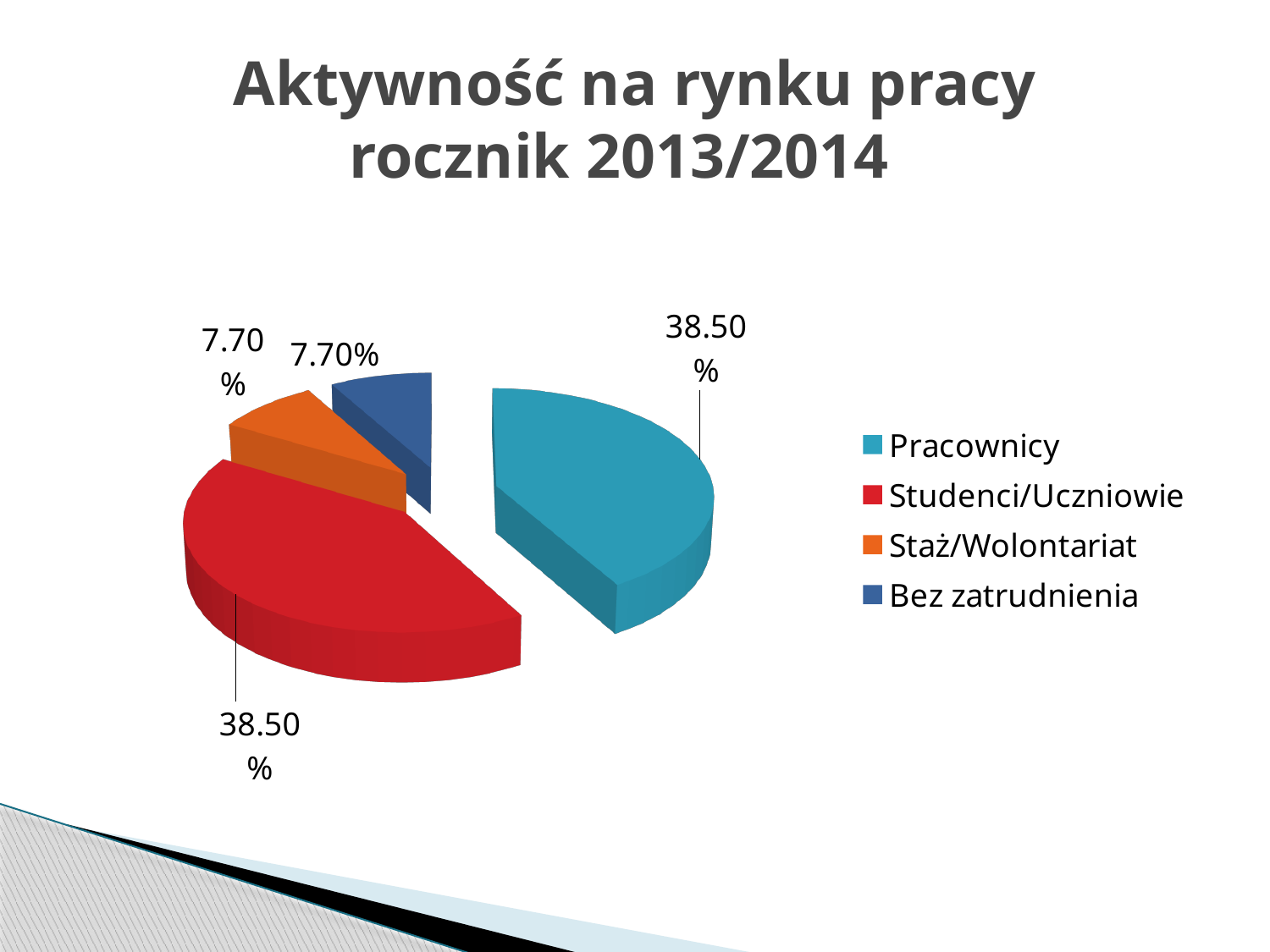
What is the combined share of Pracownicy and Studenci/Uczniowie? 77.00% What share of the pie does Pracownicy hold? 38.50% What is the title of the chart on the slide? Aktywność na rynku pracy rocznik 2013/2014 What share of the pie does Staż/Wolontariat hold? 7.70% What share of the pie does Studenci/Uczniowie hold? 38.50% Which is larger, the share for Pracownicy or the share for Staż/Wolontariat? Pracownicy Which colour represents Staż/Wolontariat in the legend? orange Which is larger, the share for Bez zatrudnienia or the share for Studenci/Uczniowie? Studenci/Uczniowie What kind of chart is shown on the slide? pie chart What share of the pie does Bez zatrudnienia hold? 7.70% What is the difference between the share for Pracownicy and the share for Bez zatrudnienia? 30.80% How many slices does the pie chart have? 4